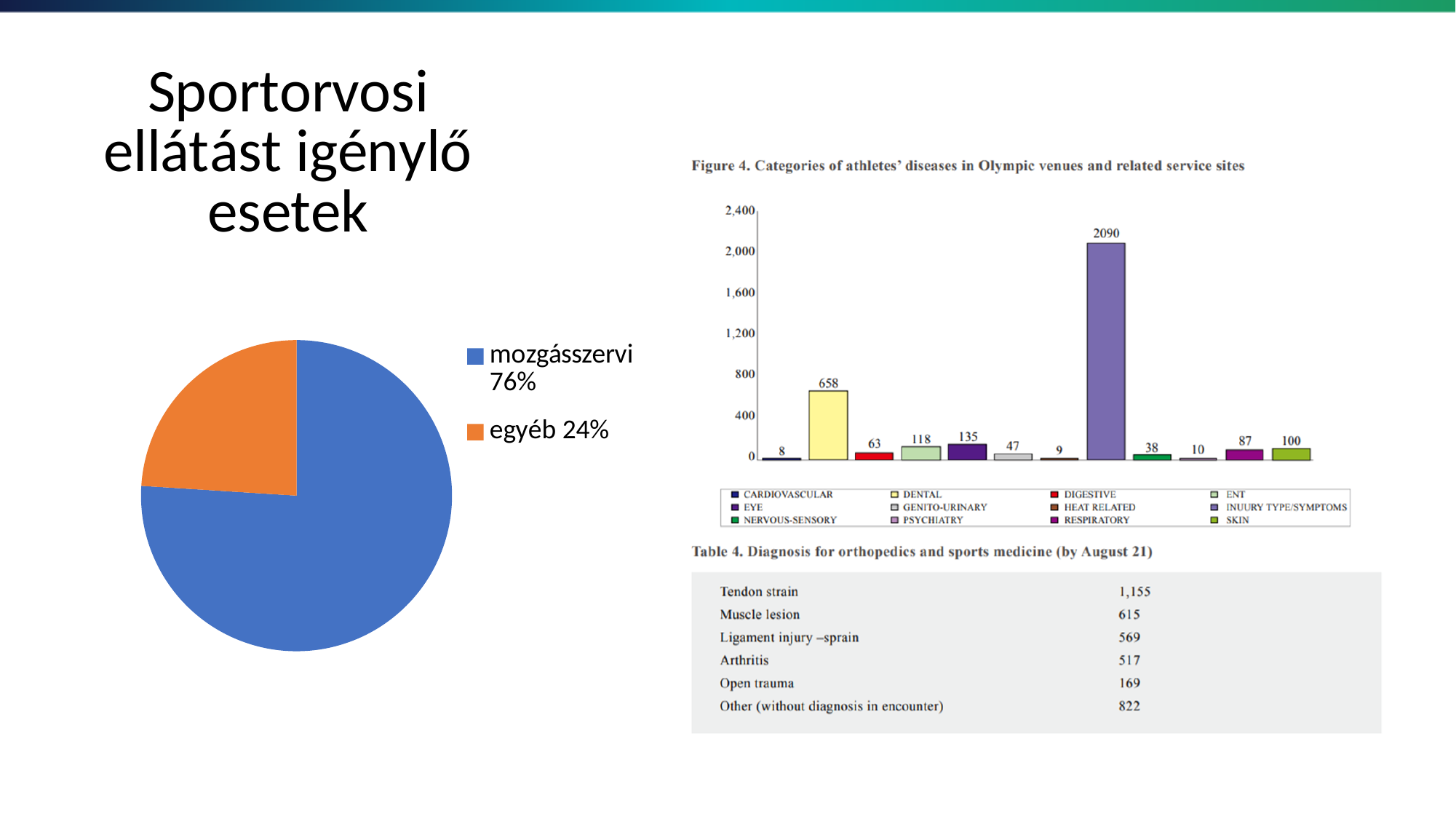
In Figure 4, what is the difference between the Dental value and the ENT value? 540 In Figure 4, which category has the highest value? Injury type/symptoms In Figure 4, which is larger, the value for Skin or the value for Respiratory? Skin In Figure 4, what is the value for Eye? 135 In Figure 4, what is the value for Injury type/symptoms? 2090 In the pie chart on the left, what share is labelled for egyéb? 24% In Figure 4, what is the value for Dental? 658 What kind of chart is Figure 4 on the right of the slide? bar chart What kind of chart is the chart on the left of the slide? pie chart How many categories does the legend of Figure 4 list? 12 How many slices does the pie chart on the left have? 2 In the pie chart on the left, what share is labelled for mozgásszervi? 76%